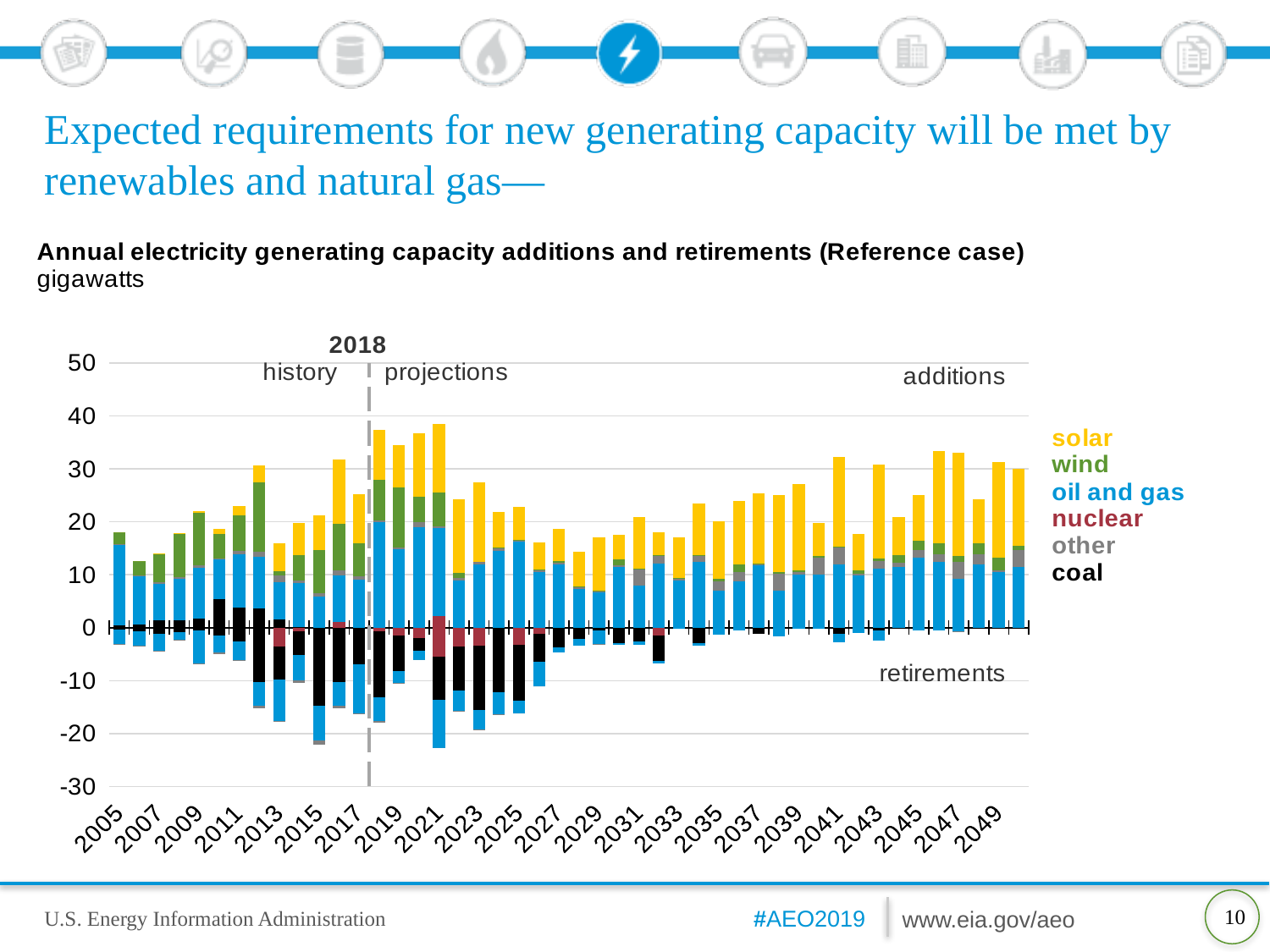
Is the total retirements value for 2015 greater or less than -10? less Is the total additions value for 2013 greater or less than 20? less What kind of chart is shown on the slide? bar chart Is the total additions value for 2021 greater or less than 30? greater How many series does the legend list? 6 What unit is the chart measured in? gigawatts What is the title of the chart? Annual electricity generating capacity additions and retirements (Reference case) Which year is marked by the dashed vertical line separating history from projections? 2018